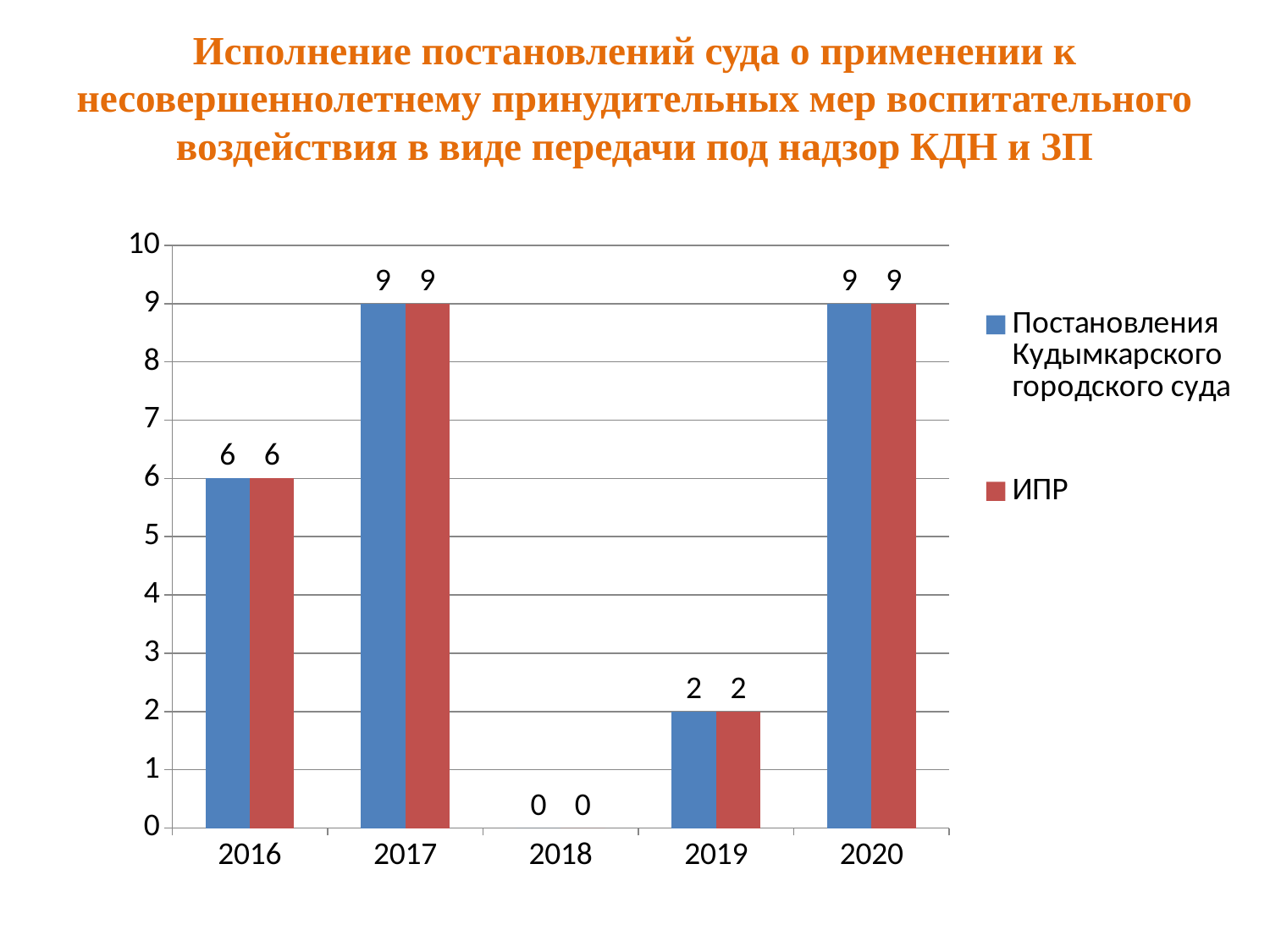
Which is larger: the Постановления Кудымкарского городского суда value in 2016 or in 2020? 2020 What colour are the bars for the ИПР series? red Which year has the lowest value for ИПР? 2018 What is the value for ИПР in 2019? 2 Do the ИПР values rise or fall from 2019 to 2020? rise What is the value for Постановления Кудымкарского городского суда in 2017? 9 What kind of chart is shown on the slide? bar chart What is the value for Постановления Кудымкарского городского суда in 2018? 0 How many years are shown on the x axis? 5 What is the difference between the ИПР value in 2017 and in 2019? 7 How many series does the legend list? 2 What is the value for ИПР in 2016? 6